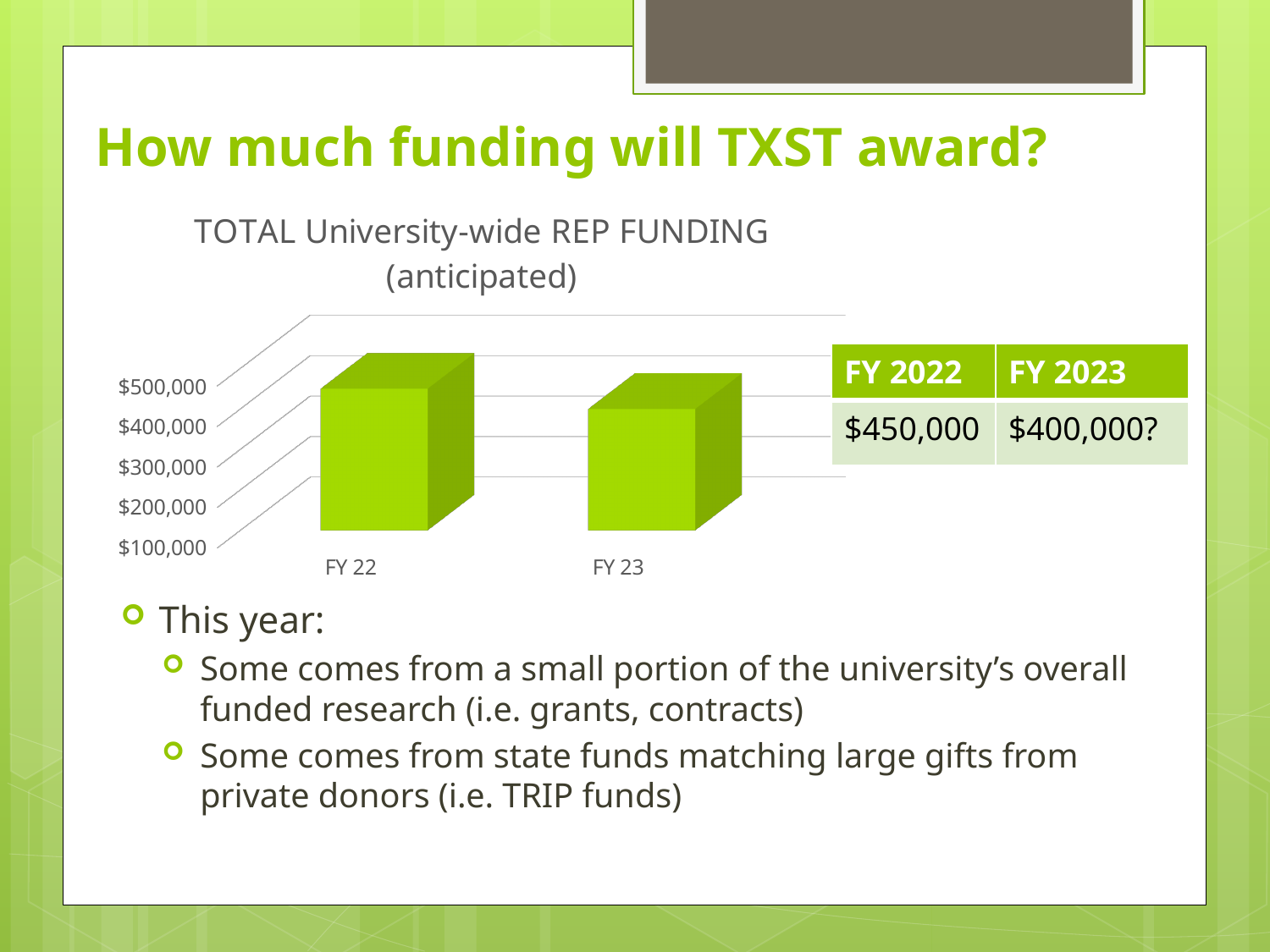
According to the table beside the chart, what is the anticipated REP funding for FY 2023? $400,000? According to the table beside the chart, what is the REP funding for FY 2022? $450,000 Do the values rise or fall from FY 22 to FY 23? fall What is the title of the chart? TOTAL University-wide REP FUNDING (anticipated) How many fiscal years are plotted in the chart? 2 What colour are the bars in the chart? green Which fiscal year has the shorter bar in the chart? FY 23 Is the value for FY 23 greater or less than $200,000? greater Is the value for FY 22 greater or less than $300,000? greater Which fiscal year has the taller bar in the chart? FY 22 What kind of chart is shown on the slide? bar chart Is the bar for FY 22 taller or shorter than the bar for FY 23? taller